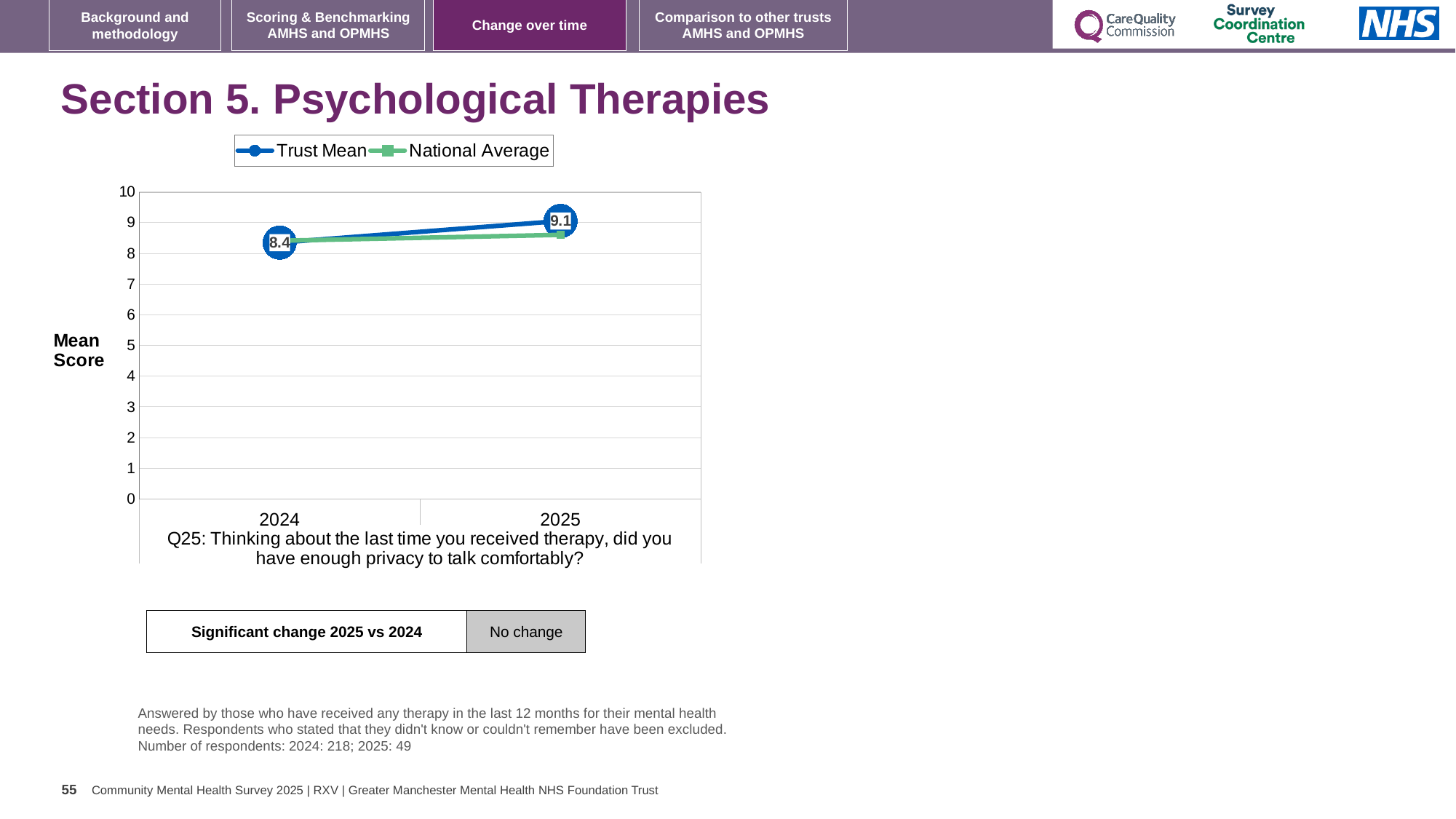
Is the National Average value for 2025 greater or less than 7? greater Is the National Average value for 2024 greater or less than 5? greater What is the Trust Mean value for 2024? 8.4 Does the Trust Mean rise or fall from 2024 to 2025? rise What kind of chart is shown on the slide? line chart Which year has the higher Trust Mean, 2024 or 2025? 2025 By how much did the Trust Mean change from 2024 to 2025? 0.7 How many years are shown on the x axis of the chart? 2 In 2025, which series is higher, Trust Mean or National Average? Trust Mean How many series does the legend list? 2 What is the label on the y axis of the chart? Mean Score What is the Trust Mean value for 2025? 9.1